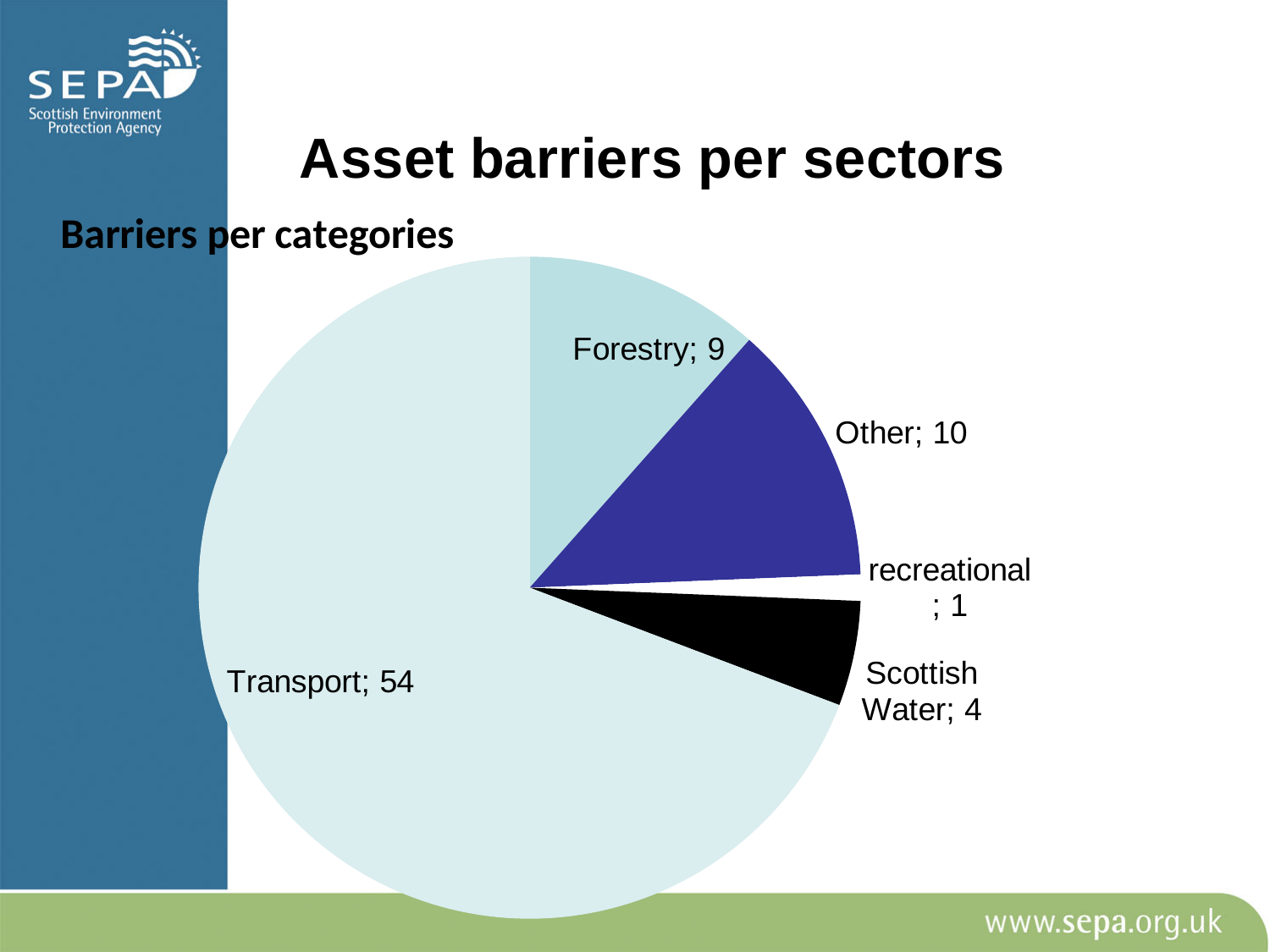
What is the total of all the slices in the pie chart? 78 What kind of chart is shown on the slide? Pie chart What is the value for Scottish Water? 4 What is the value for recreational? 1 How many categories does the pie chart show? 5 What is the title of the chart? Asset barriers per sectors What is the value for Transport? 54 Which is larger, the value for Other or the value for Forestry? Other Which category has the largest slice? Transport What is the value for Forestry? 9 What is the difference between the values for Transport and Other? 44 Which category has the smallest slice? recreational